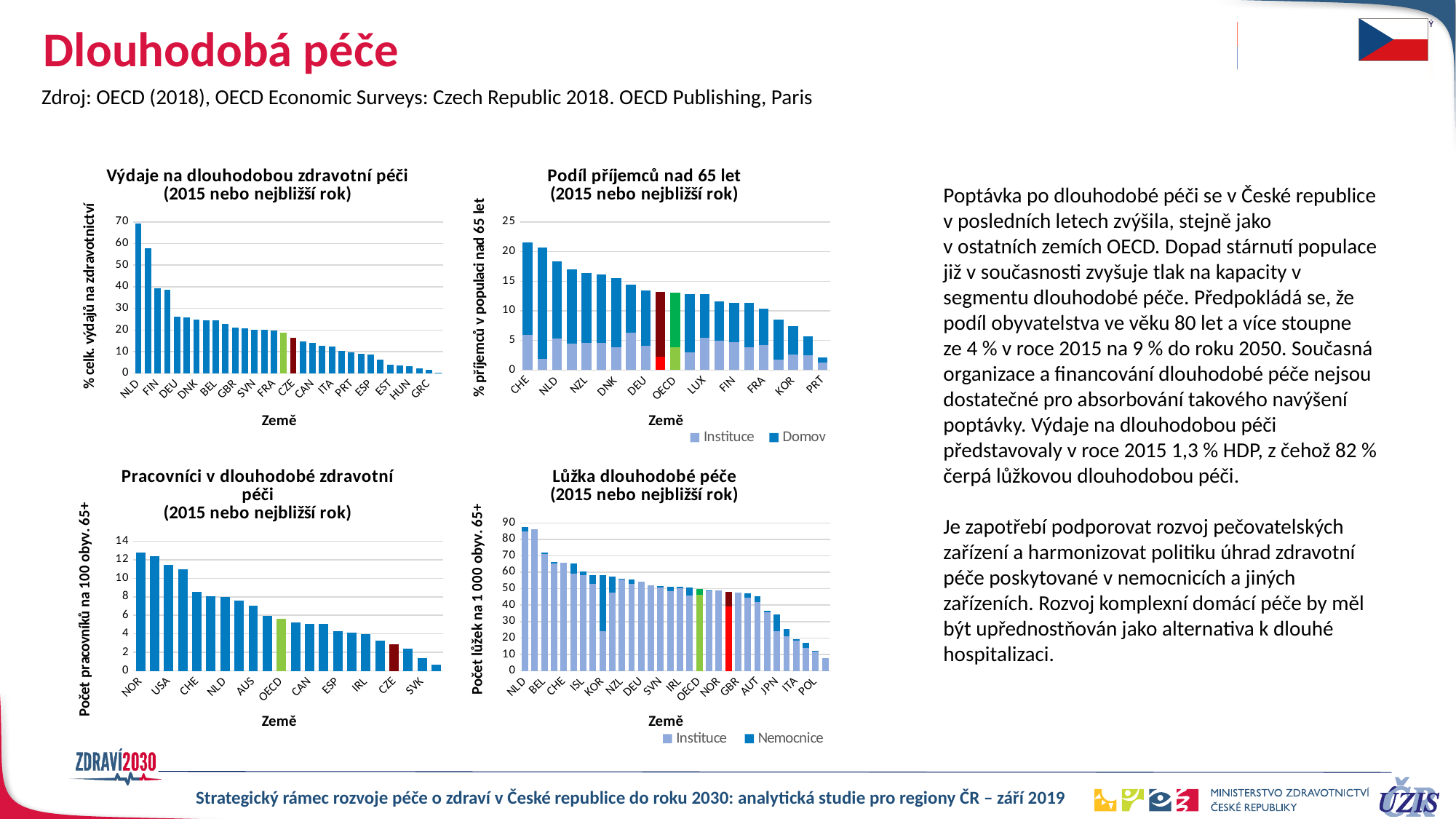
In the chart 'Výdaje na dlouhodobou zdravotní péči', which country has the highest value? NLD In the chart 'Pracovníci v dlouhodobé zdravotní péči', is the value for NOR greater or less than 10? greater In the chart 'Podíl příjemců nad 65 let', is the total for PRT greater or less than 5? less In the chart 'Výdaje na dlouhodobou zdravotní péči', do the values rise or fall from left to right along the x axis? fall In the chart 'Lůžka dlouhodobé péče', which country has the highest total? NLD In the chart 'Podíl příjemců nad 65 let', which country has the highest total? CHE In the chart 'Lůžka dlouhodobé péče', is the total for POL greater or less than 20? less What kind of chart is 'Lůžka dlouhodobé péče'? stacked bar chart In the chart 'Podíl příjemců nad 65 let', how many series does the legend list? 2 In the chart 'Pracovníci v dlouhodobé zdravotní péči', which is larger, the value for OECD or the value for CZE? OECD